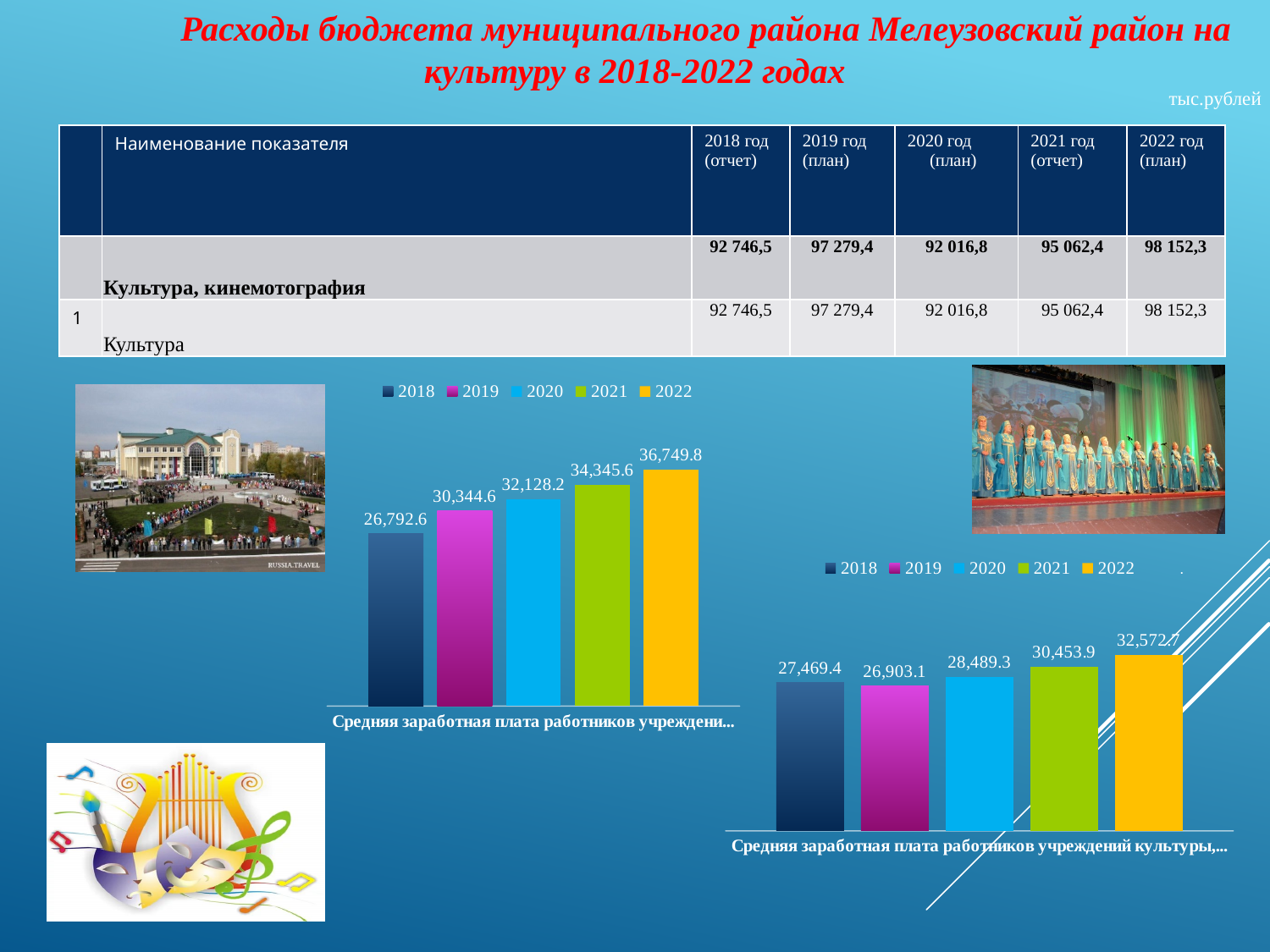
In the left chart, what is the value for 2018? 26,792.6 In the right chart, what is the value for 2021? 30,453.9 What kind of chart is the right chart? Bar chart In the left chart, what is the difference between the 2022 and 2018 values? 9,957.2 In the left chart, what is the value for 2022? 36,749.8 In the right chart, which is larger, the value for 2018 or the value for 2019? 2018 In the left chart, do the values rise or fall from 2018 to 2022? Rise In the right chart, which year has the lowest value? 2019 In the right chart, what is the value for 2019? 26,903.1 In the left chart, which year has the highest value? 2022 In the right chart, what is the difference between the 2022 and 2021 values? 2,118.8 How many series does the legend of the left chart list? 5